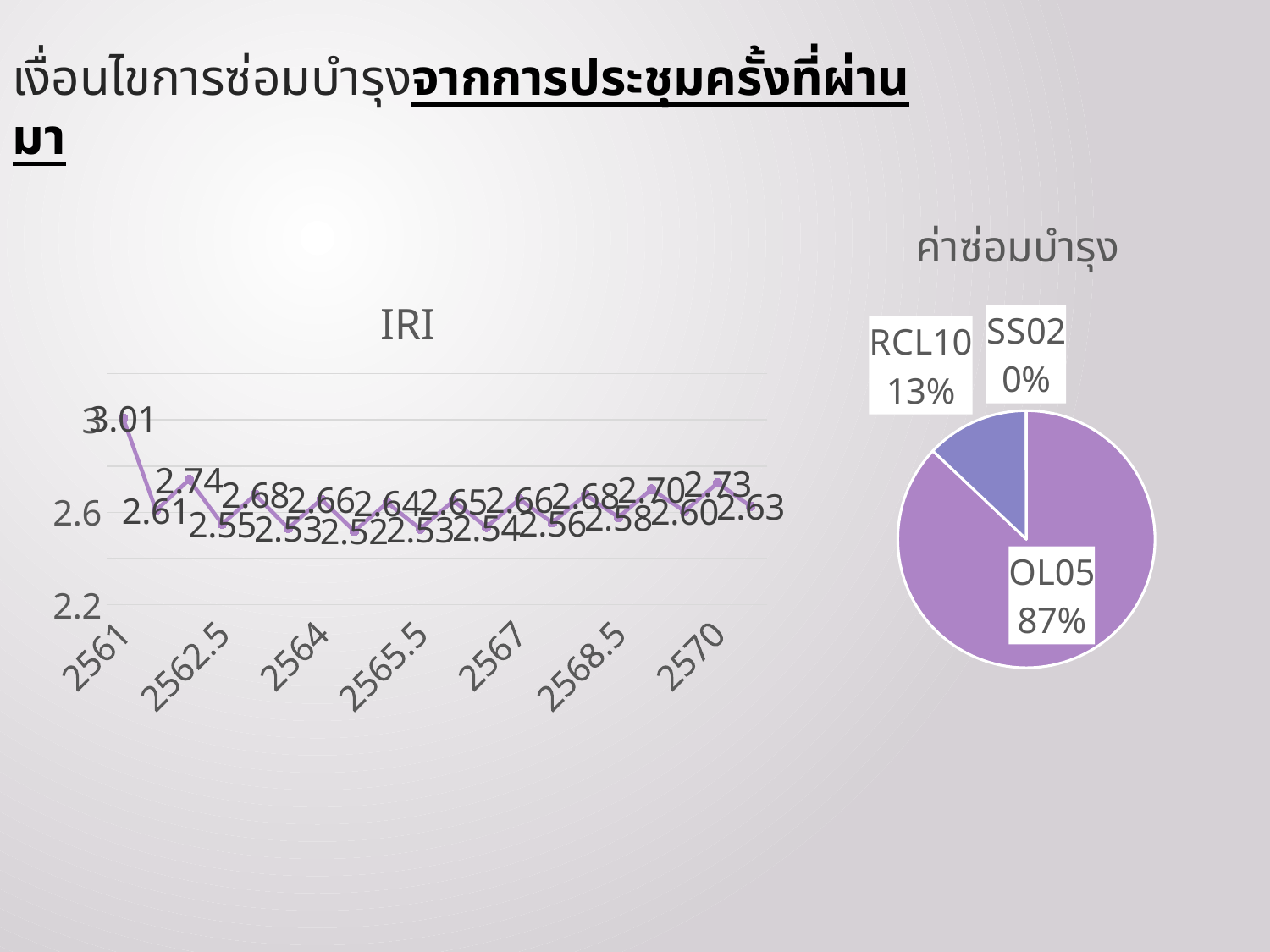
In the pie chart titled "ค่าซ่อมบำรุง", which category has the largest share? OL05 In the pie chart titled "ค่าซ่อมบำรุง", what share does OL05 have? 87% In the line chart titled "IRI", what is the lowest value plotted? 2.52 In the pie chart titled "ค่าซ่อมบำรุง", how many categories are shown? 3 In the pie chart titled "ค่าซ่อมบำรุง", which is larger, RCL10 or OL05? OL05 In the pie chart titled "ค่าซ่อมบำรุง", what share does SS02 have? 0% What kind of chart is the chart titled "IRI"? line chart In the pie chart titled "ค่าซ่อมบำรุง", which category has the smallest share? SS02 What kind of chart is the chart titled "ค่าซ่อมบำรุง"? pie chart In the line chart titled "IRI", what is the highest value plotted? 3.01 In the pie chart titled "ค่าซ่อมบำรุง", what share does RCL10 have? 13% In the pie chart titled "ค่าซ่อมบำรุง", what is the difference in percentage points between OL05 and RCL10? 74%